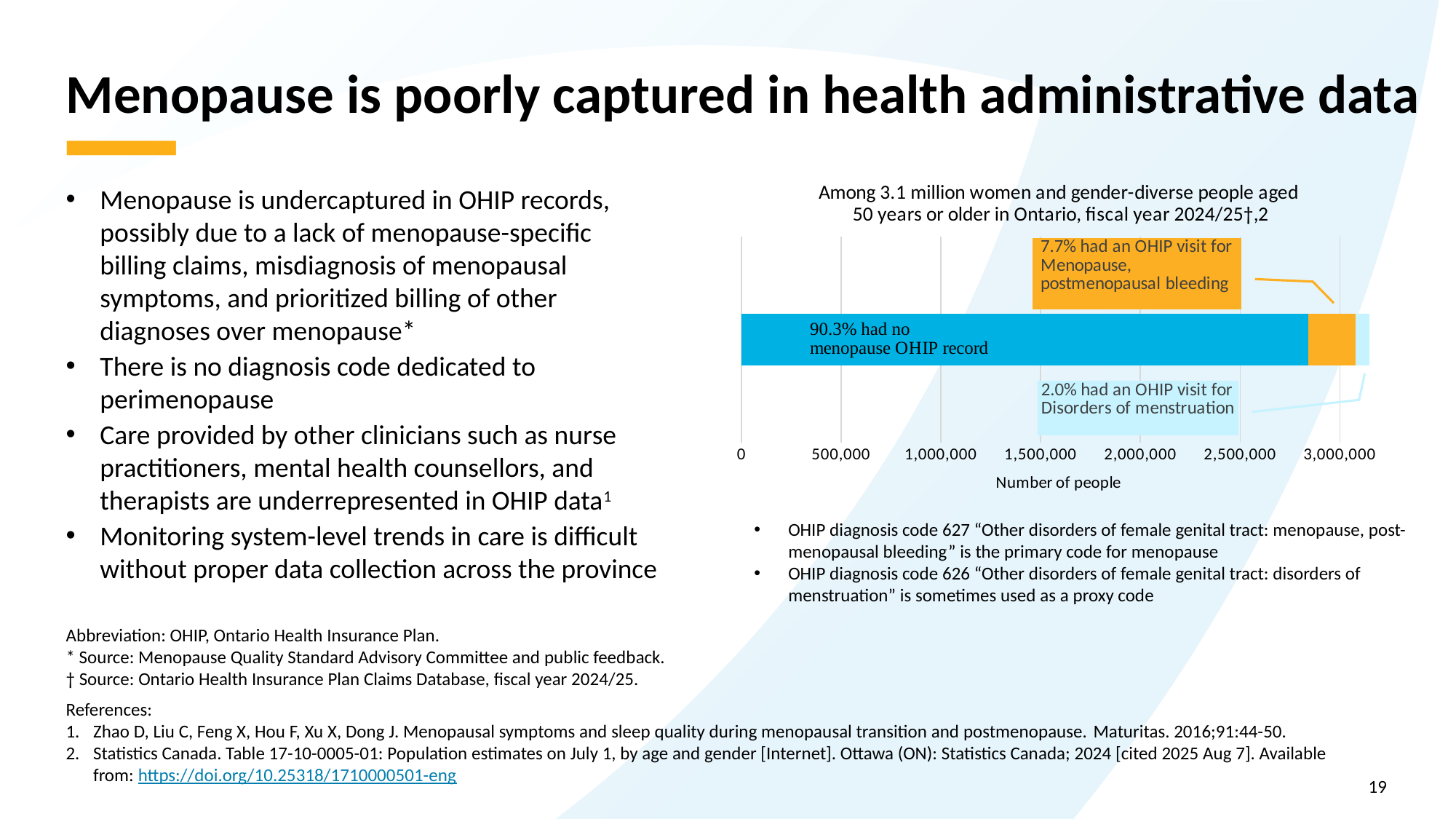
Which segment of the bar represents the smallest share of people? OHIP visit for Disorders of menstruation How many segments make up the stacked bar? 3 Which segment of the bar represents the largest share of people? No menopause OHIP record What is the label of the x axis of the chart? Number of people What percentage had an OHIP visit for Disorders of menstruation? 2.0% What kind of chart is shown on the slide? Stacked bar chart Which is larger: the share with an OHIP visit for Menopause, postmenopausal bleeding or the share with an OHIP visit for Disorders of menstruation? OHIP visit for Menopause, postmenopausal bleeding What percentage of people had no menopause OHIP record? 90.3% What is the difference in percentage points between those with an OHIP visit for Menopause, postmenopausal bleeding and those with an OHIP visit for Disorders of menstruation? 5.7 percentage points What colour is the segment for people with no menopause OHIP record? Blue What percentage had an OHIP visit for Menopause, postmenopausal bleeding? 7.7% Is the number of people with no menopause OHIP record greater or less than 2,500,000? greater